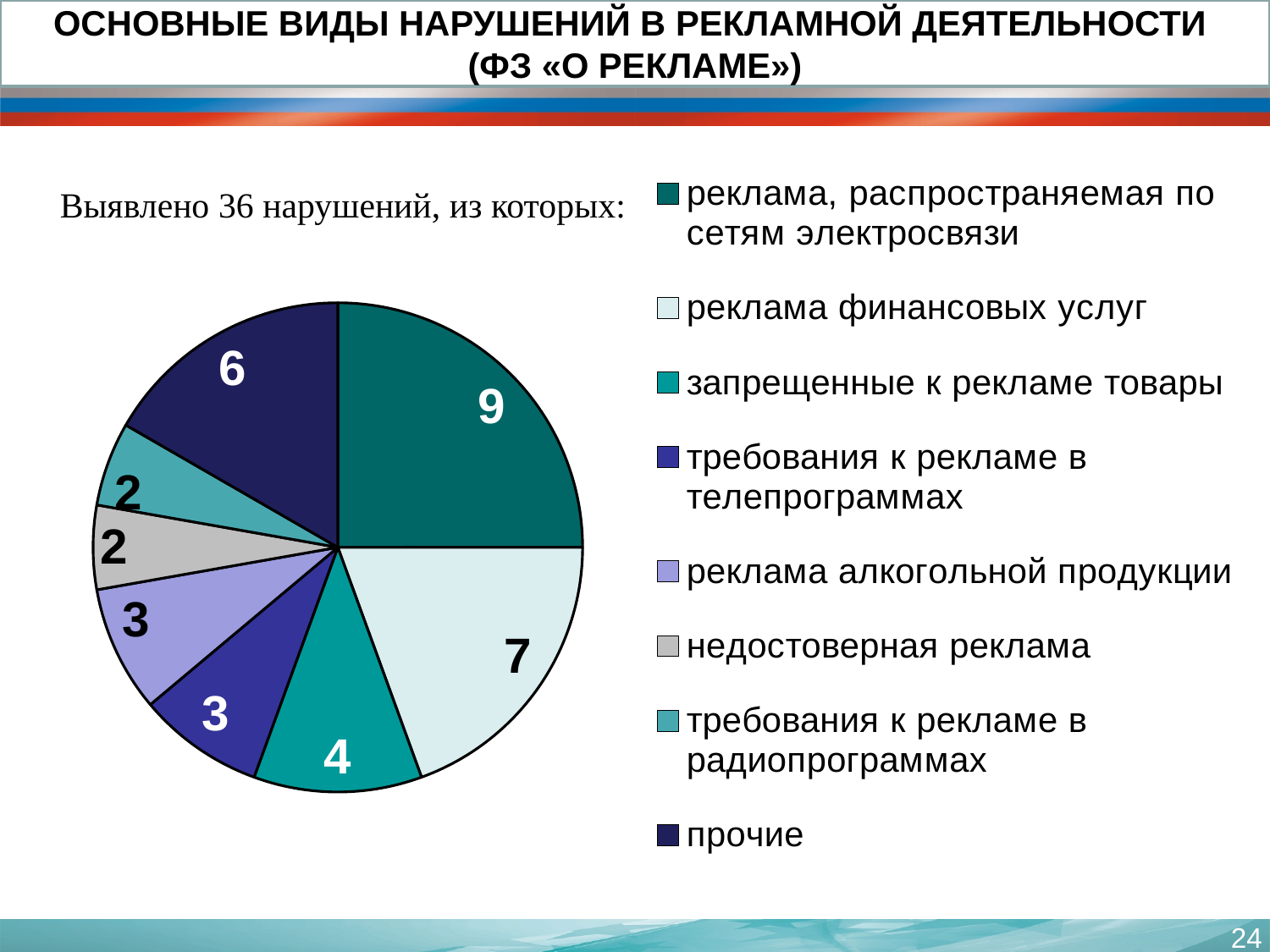
What is the value for «реклама, распространяемая по сетям электросвязи»? 9 Which category has the largest slice of the pie? реклама, распространяемая по сетям электросвязи What share of the pie does the slice with value 9 represent? 25% How many entries does the legend list? 8 What is the value for «реклама финансовых услуг»? 7 What is the value for «прочие»? 6 Which is larger: the value for «прочие» or the value for «запрещенные к рекламе товары»? прочие What is the difference between the values for «реклама, распространяемая по сетям электросвязи» and «реклама финансовых услуг»? 2 What type of chart is shown on the slide? pie chart What is the total of all slices in the pie chart? 36 What is the value for «запрещенные к рекламе товары»? 4 How many slices does the pie chart have? 8